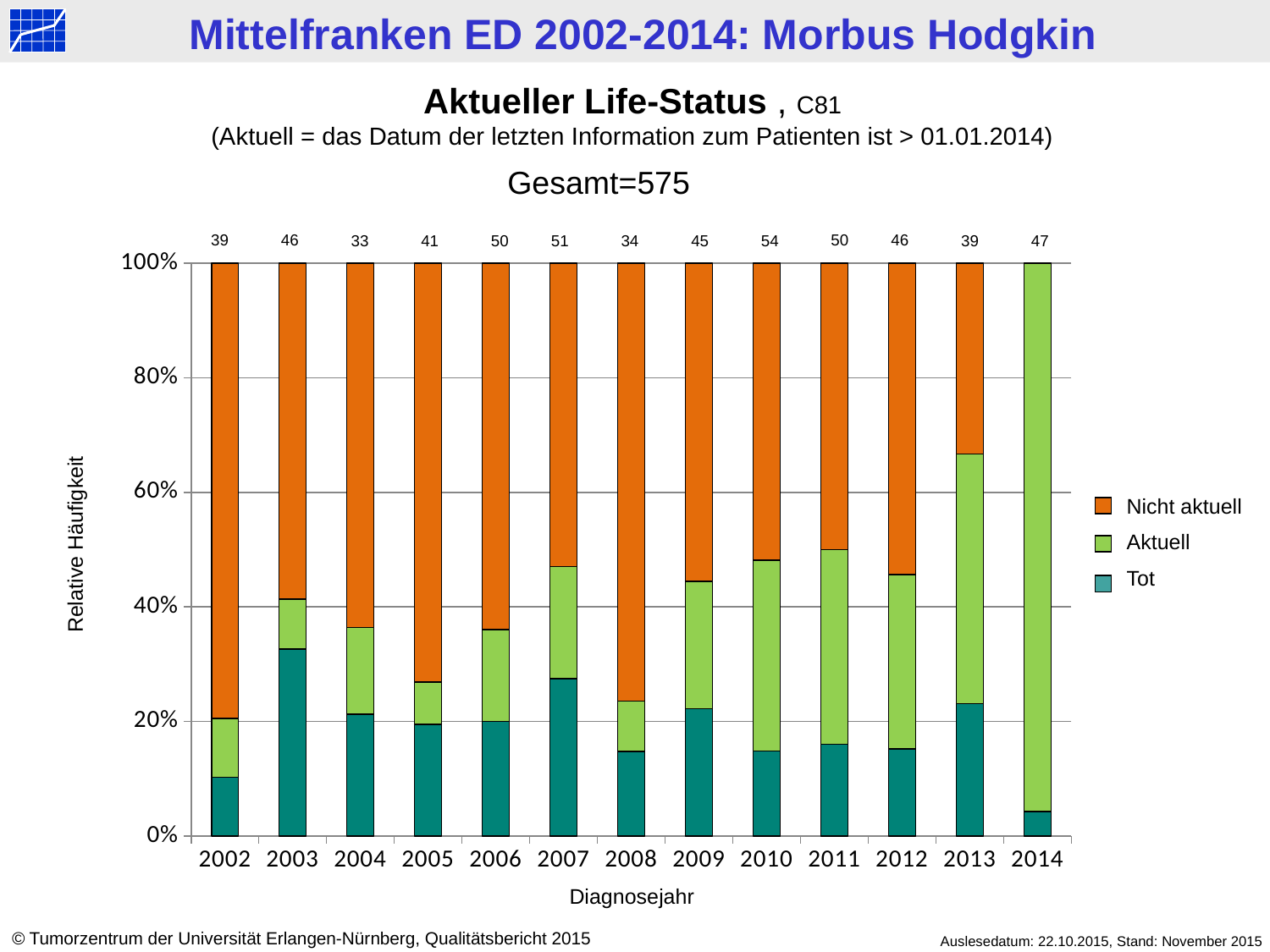
What is the number printed above the bar for 2004? 33 What is the difference between the numbers printed above the bars for 2010 and 2004? 21 Which diagnosis year has the highest number printed above its bar? 2010 Which year has a larger number printed above its bar, 2007 or 2008? 2007 Which diagnosis year has the lowest number printed above its bar? 2004 What kind of chart is shown on the slide? Stacked bar chart What is the number printed above the bar for 2010? 54 Is the share of 'Tot' in 2003 greater or less than 20%? greater What is the total number of patients (Gesamt) stated on the slide? 575 How many series does the legend list? 3 How many diagnosis years are shown on the x axis? 13 What is the number printed above the bar for 2014? 47